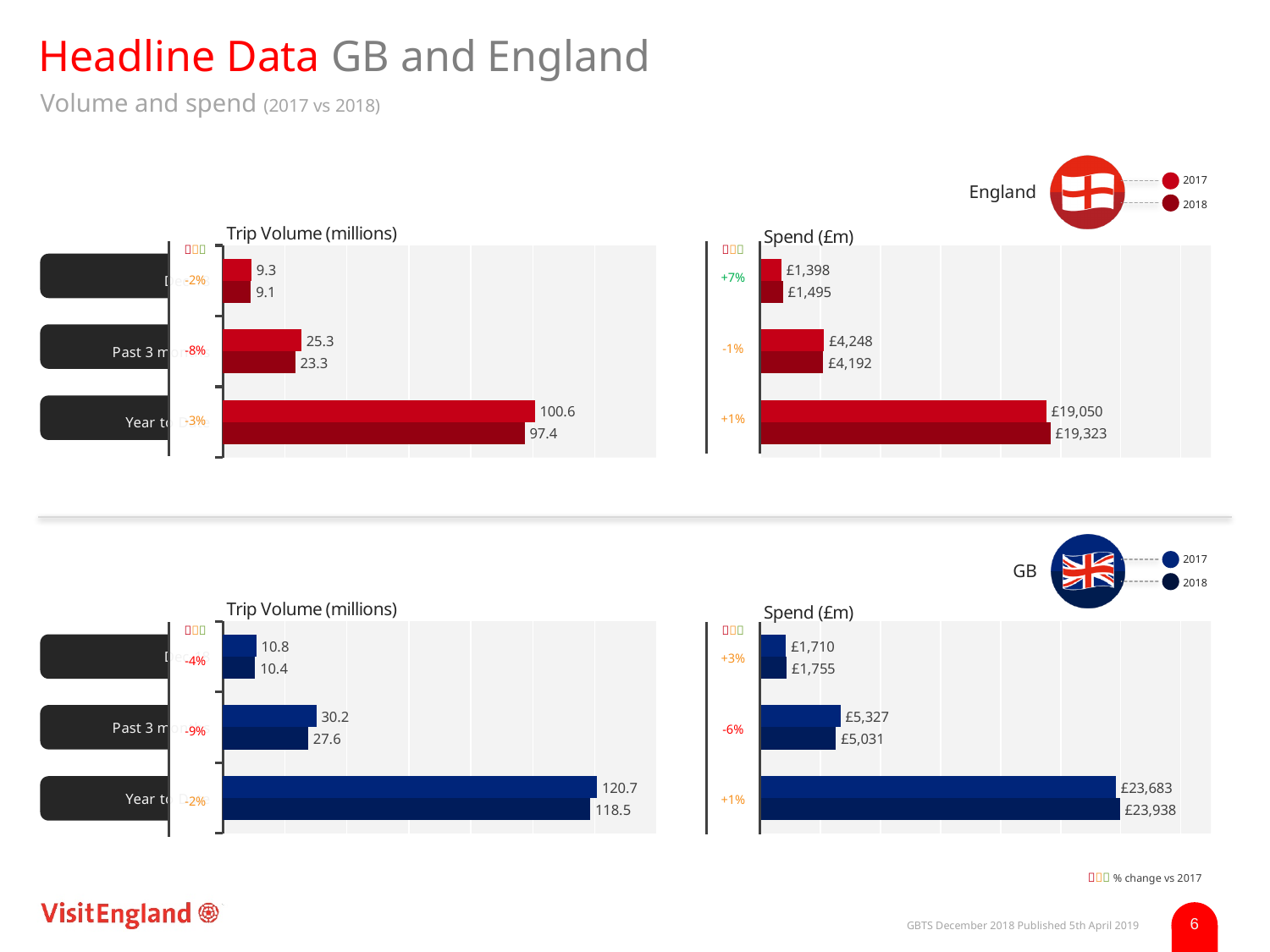
In the England Spend (£m) chart, which year has the larger value for the top category, 2017 or 2018? 2018 What kind of chart is the GB Spend (£m) chart? Bar chart In the England Trip Volume (millions) chart, what is the difference between the 2017 and 2018 values for the bottom category? 3.2 In the GB Spend (£m) chart, what is the 2018 value for the top category? £1,755 In the England Spend (£m) chart, what is the 2018 value for the bottom category? £19,323 In the GB Trip Volume (millions) chart, what is the 2017 value for the middle category? 30.2 What % change vs 2017 is shown next to the top category in the England Spend (£m) chart? +7% In the England Trip Volume (millions) chart, what is the 2017 value for the bottom category? 100.6 How many series does the legend for the England charts list? 2 How many categories are plotted in the England Trip Volume (millions) chart? 3 In the GB Trip Volume (millions) chart, which year has the larger value for the bottom category, 2017 or 2018? 2017 In the GB Spend (£m) chart, what is the difference between the 2017 and 2018 values for the middle category? £296